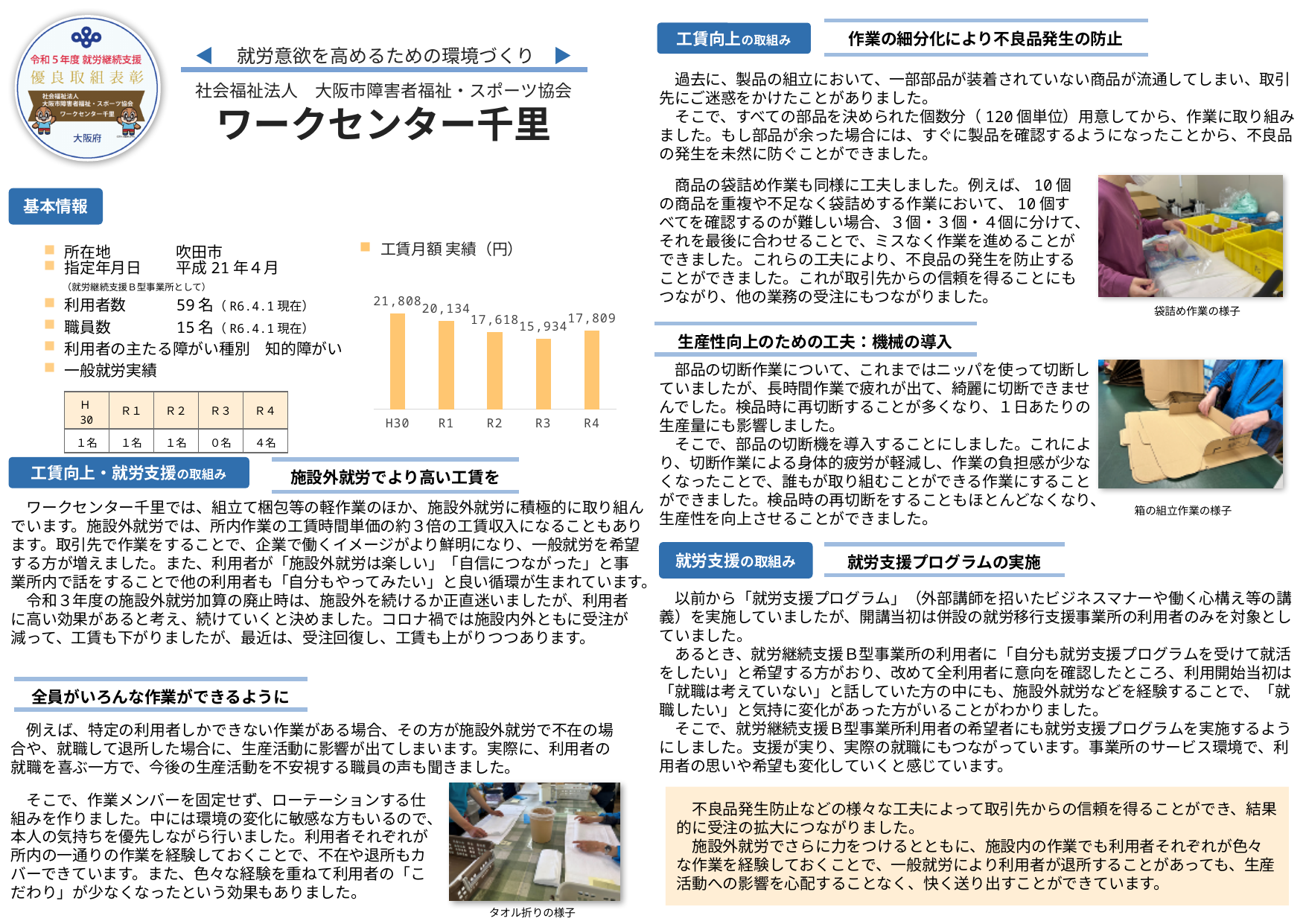
Which category has the highest value in the 工賃月額 実績（円） chart? H30 What is the value for H30 in the 工賃月額 実績（円） chart? 21,808 What is the difference between the H30 and R1 values in the 工賃月額 実績（円） chart? 1,674 What is the value for R3 in the 工賃月額 実績（円） chart? 15,934 What is the value for R4 in the 工賃月額 実績（円） chart? 17,809 Do the values in the 工賃月額 実績（円） chart rise or fall from H30 to R3? fall What is the difference between the R4 and R3 values in the 工賃月額 実績（円） chart? 1,875 Which category has the lowest value in the 工賃月額 実績（円） chart? R3 How many categories are shown on the x axis of the 工賃月額 実績（円） chart? 5 What kind of chart is the 工賃月額 実績（円） chart? bar chart What is the title of the chart on the slide? 工賃月額 実績（円） In the 工賃月額 実績（円） chart, which is larger, the value for R1 or the value for R2? R1